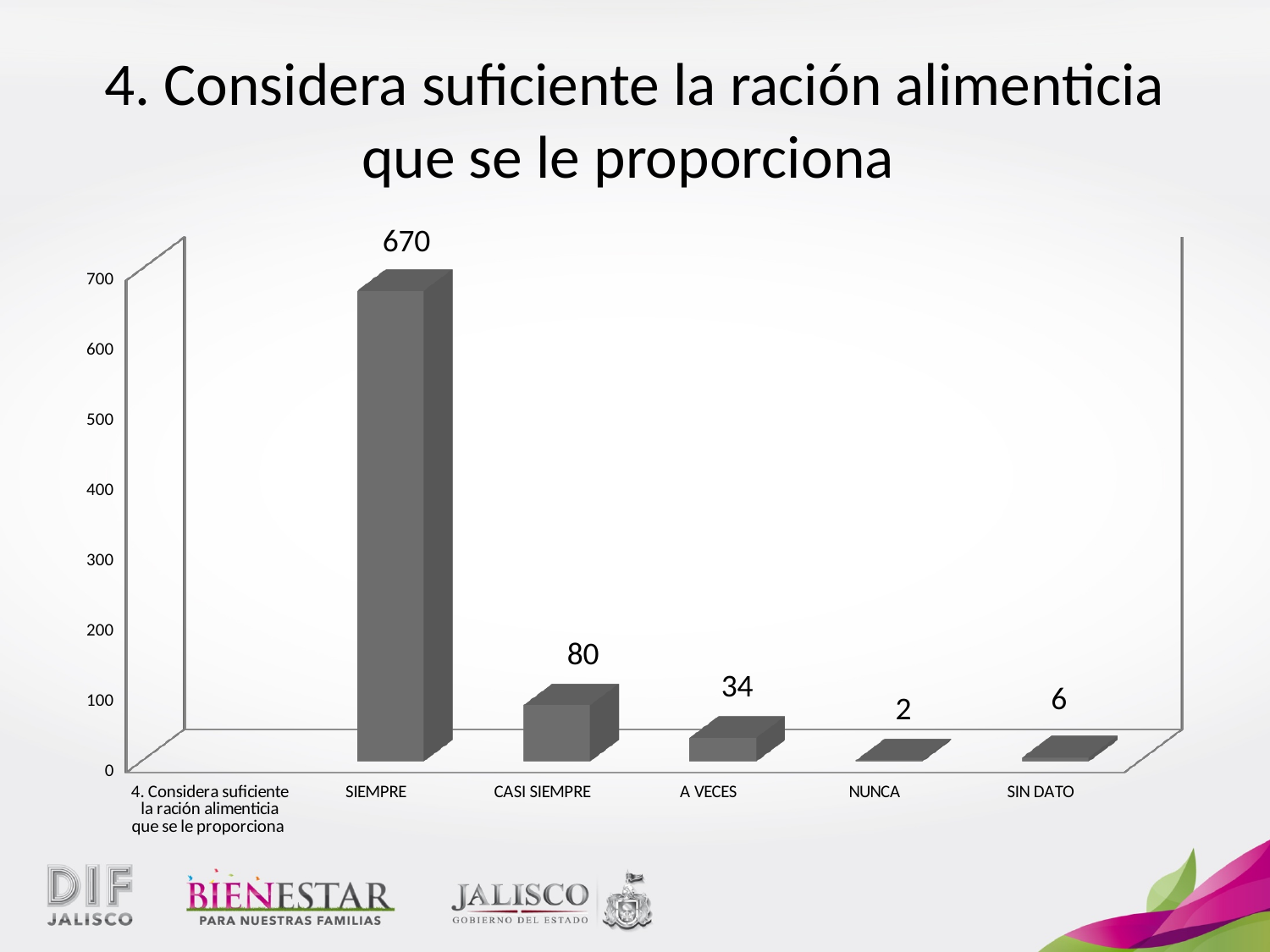
Is the value for CASI SIEMPRE greater or less than 100? less Which is larger, the value for A VECES or the value for SIN DATO? A VECES What is the value for CASI SIEMPRE? 80 What is the value for SIN DATO? 6 What kind of chart is shown on the slide? bar chart What is the value for NUNCA? 2 What is the difference between the values for SIEMPRE and CASI SIEMPRE? 590 Which category has the highest value? SIEMPRE Which category has the lowest value? NUNCA What is the value for SIEMPRE? 670 What is the value for A VECES? 34 How many bars are plotted in the chart? 5